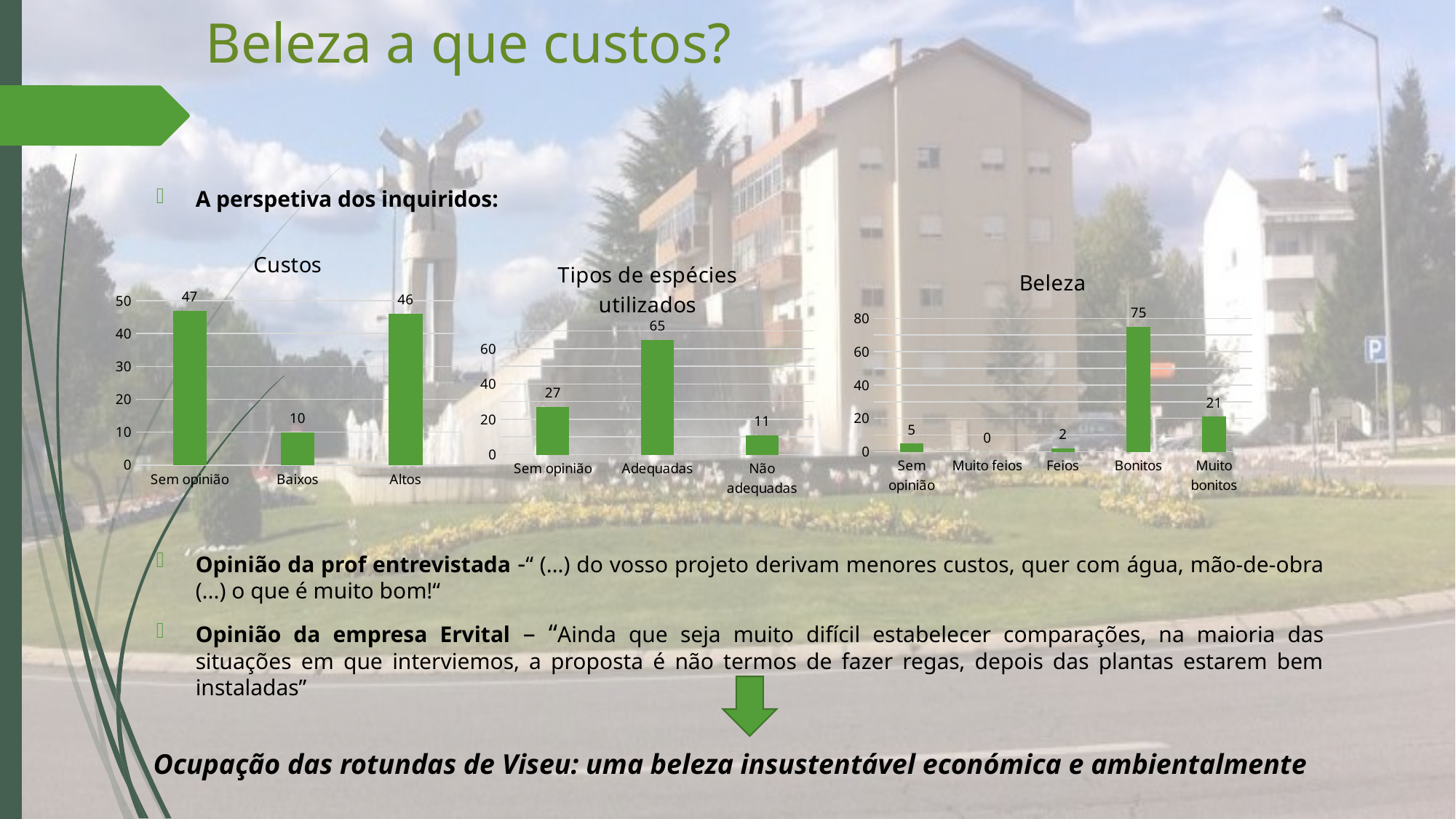
What kind of chart is the 'Custos' chart? Bar chart In the 'Beleza' chart, which category has the lowest value? Muito feios In the 'Beleza' chart, what is the value for 'Feios'? 2 In the 'Custos' chart, what is the value for 'Sem opinião'? 47 In the 'Beleza' chart, which is larger, 'Bonitos' or 'Muito bonitos'? Bonitos In the 'Tipos de espécies utilizados' chart, what is the value for 'Adequadas'? 65 In the 'Beleza' chart, what is the value for 'Muito bonitos'? 21 In the 'Tipos de espécies utilizados' chart, which category has the highest value? Adequadas In the 'Custos' chart, which category has the lowest value? Baixos How many categories does the 'Beleza' chart show? 5 In the 'Tipos de espécies utilizados' chart, what is the difference between 'Sem opinião' and 'Não adequadas'? 16 In the 'Custos' chart, what is the difference between 'Sem opinião' and 'Altos'? 1